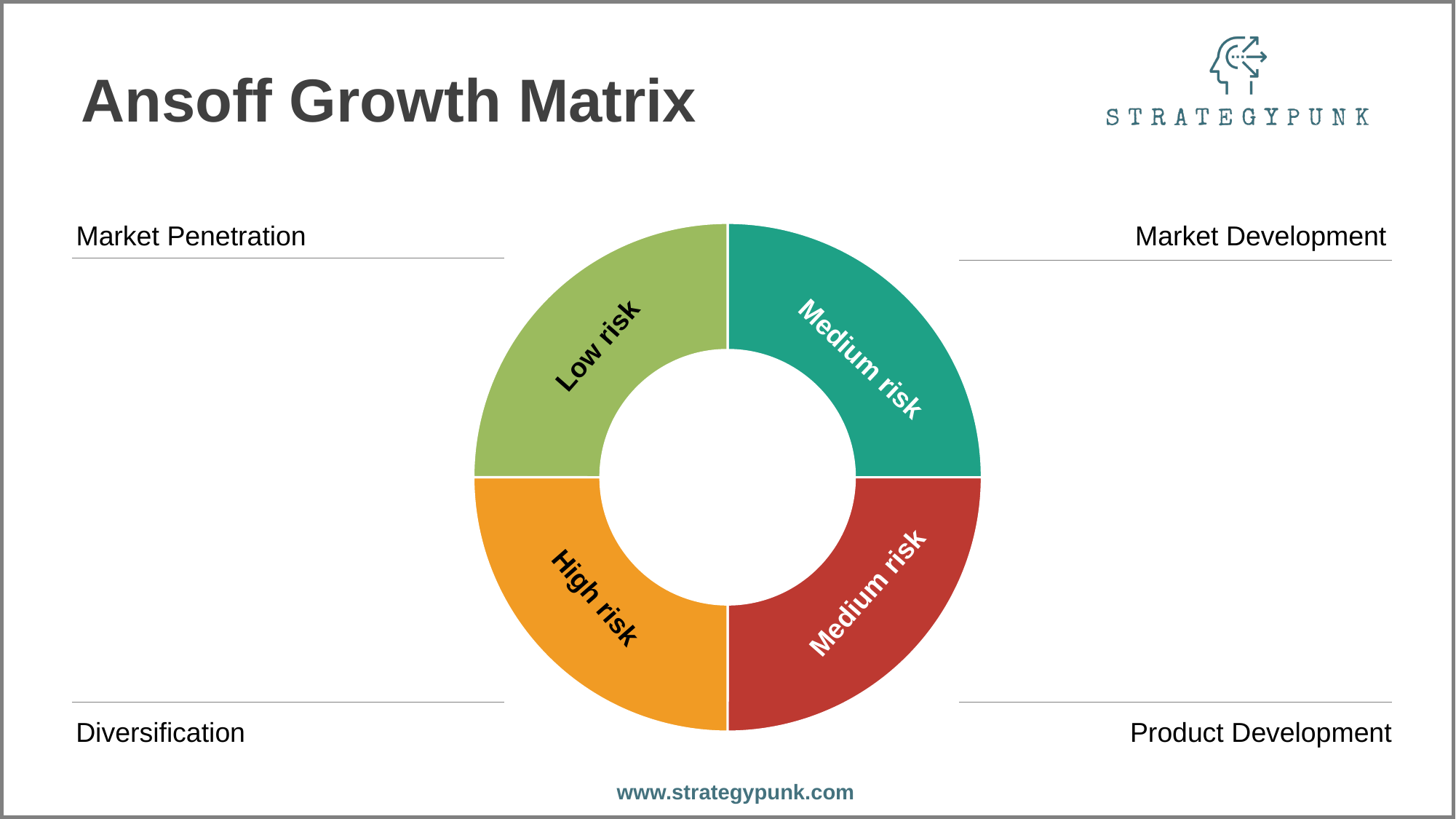
What kind of chart is shown on the slide? Doughnut chart Which growth strategy label is placed next to the "Low risk" segment in the top left? Market Penetration What label is shown on the red segment in the bottom right of the doughnut chart? Medium risk How many segments of the doughnut chart are labelled "Medium risk"? 2 How many segments does the doughnut chart have? 4 What is the title of the slide containing the chart? Ansoff Growth Matrix Which growth strategy label is placed next to the "High risk" segment in the bottom left? Diversification What label is shown on the orange segment of the doughnut chart? High risk What label is shown on the green segment of the doughnut chart? Low risk What label is shown on the teal segment in the top right of the doughnut chart? Medium risk What colour is the segment labelled "High risk"? Orange